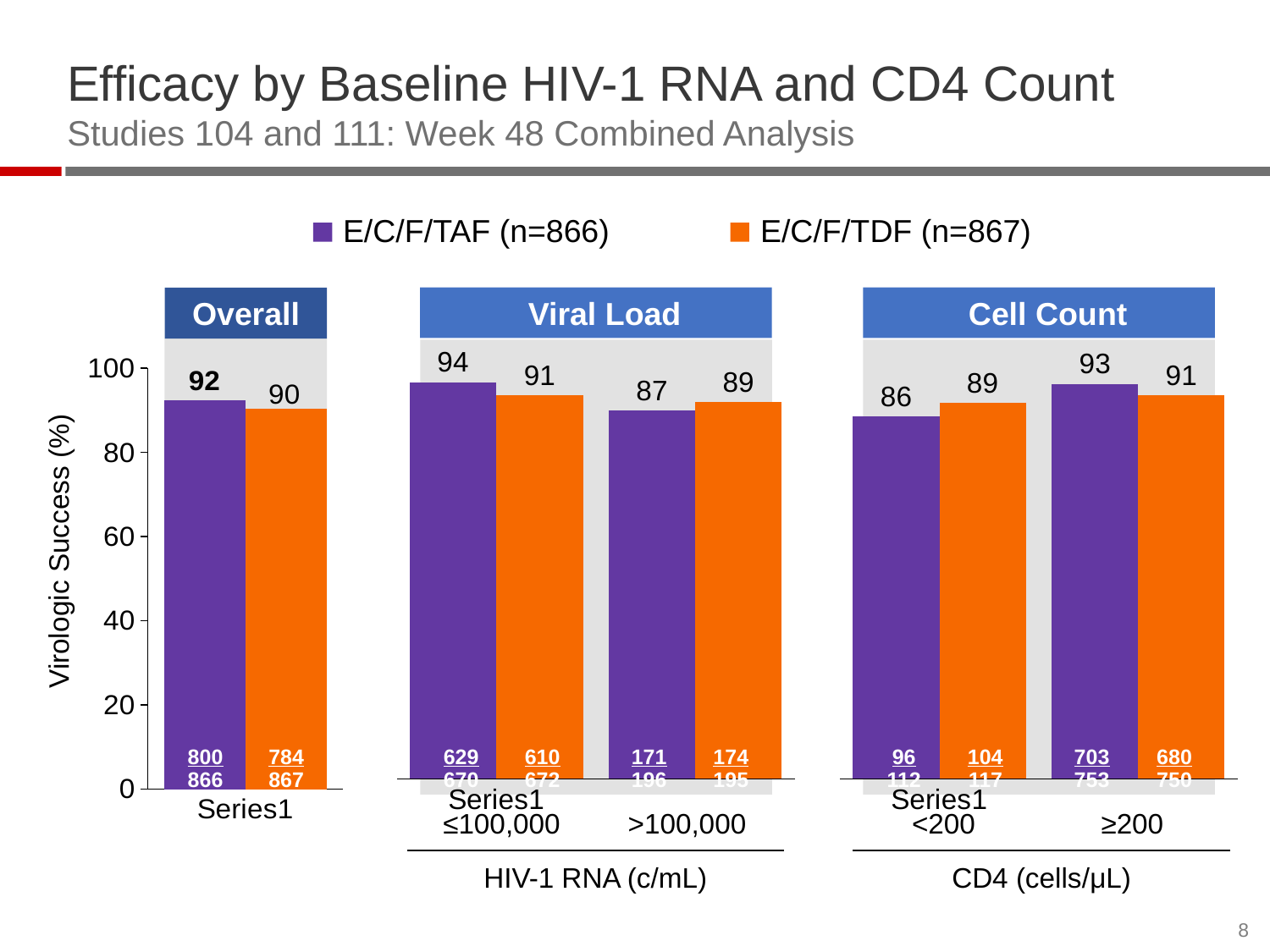
In the Cell Count chart, which series has the larger value in the <200 group, E/C/F/TAF or E/C/F/TDF? E/C/F/TDF In the Overall chart, what is the virologic success value for E/C/F/TDF? 90 In the Viral Load chart, what is the value for E/C/F/TDF in the >100,000 group? 89 How many series does the legend list? 2 In the Cell Count chart, what is the value for E/C/F/TAF in the <200 group? 86 In the Cell Count chart, which bar has the highest value? E/C/F/TAF in the ≥200 group (93) In the Cell Count chart, what is the value for E/C/F/TDF in the ≥200 group? 91 In the Viral Load chart, what is the difference between the E/C/F/TAF and E/C/F/TDF values in the ≤100,000 group? 3 In the Viral Load chart, what is the value for E/C/F/TAF in the ≤100,000 group? 94 What kind of chart is used on this slide? Bar chart In the Overall chart, what is the virologic success value for E/C/F/TAF? 92 In the Viral Load chart, which bar has the lowest value? E/C/F/TAF in the >100,000 group (87)